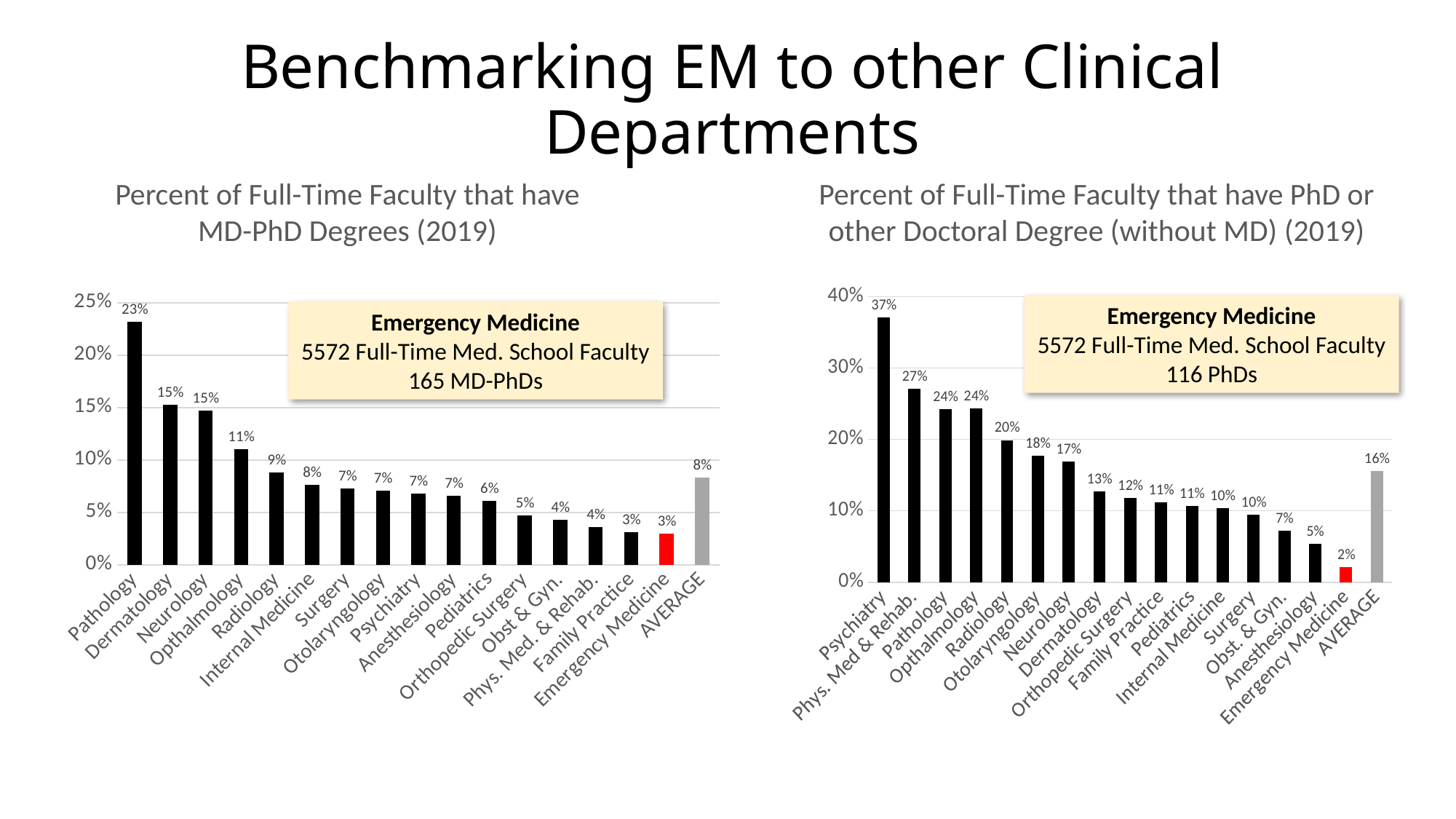
In the right chart (PhD or other Doctoral Degree), what is the value for Emergency Medicine? 2% In the left chart (MD-PhD Degrees), which department has the highest value? Pathology In the left chart (MD-PhD Degrees), what is the value for Emergency Medicine? 3% In the left chart (MD-PhD Degrees), what is the value for AVERAGE? 8% In the right chart (PhD or other Doctoral Degree), which department has the lowest value? Emergency Medicine In the right chart (PhD or other Doctoral Degree), what is the value for Psychiatry? 37% In the left chart (MD-PhD Degrees), what is the value for Pathology? 23% In the right chart (PhD or other Doctoral Degree), what is the difference between AVERAGE and Emergency Medicine? 14% How many bars are plotted in the right chart (PhD or other Doctoral Degree)? 17 In the left chart (MD-PhD Degrees), what is the difference between Pathology and Emergency Medicine? 20% What type of chart is the left chart (MD-PhD Degrees)? Bar chart In the right chart (PhD or other Doctoral Degree), which is larger, Radiology or Dermatology? Radiology